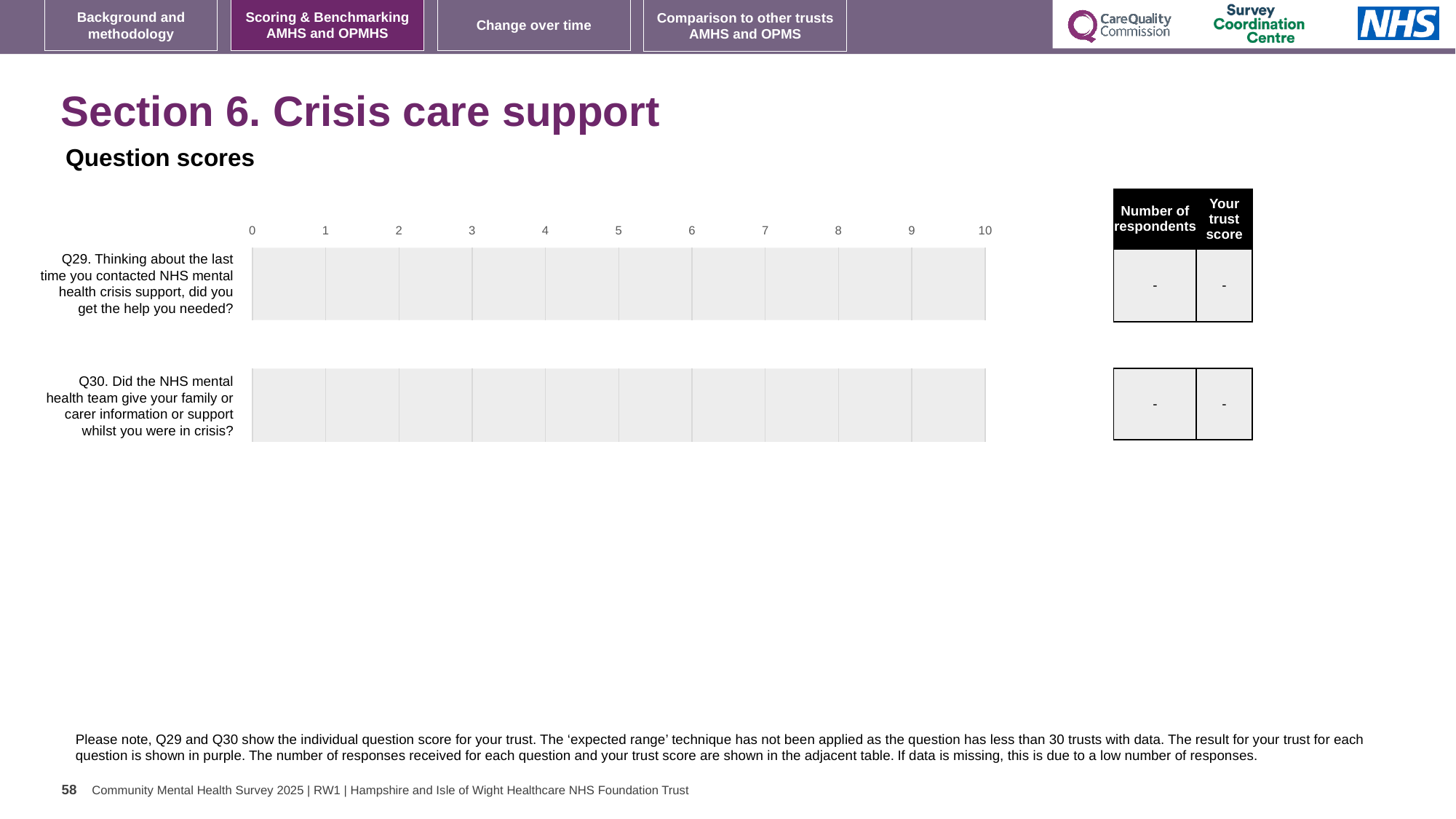
Which question number is listed first (at the top) on the chart? Q29 What is shown in the 'Number of respondents' column for Q30? - What is shown in the 'Number of respondents' column for Q29? - What kind of chart is shown on the slide? bar chart What is the lowest value shown on the chart's x axis? 0 Which question number is listed second on the chart? Q30 What is the highest value shown on the chart's x axis? 10 What is shown in the 'Your trust score' column for Q30? - What is shown in the 'Your trust score' column for Q29? - How many questions (categories) are listed on the chart? 2